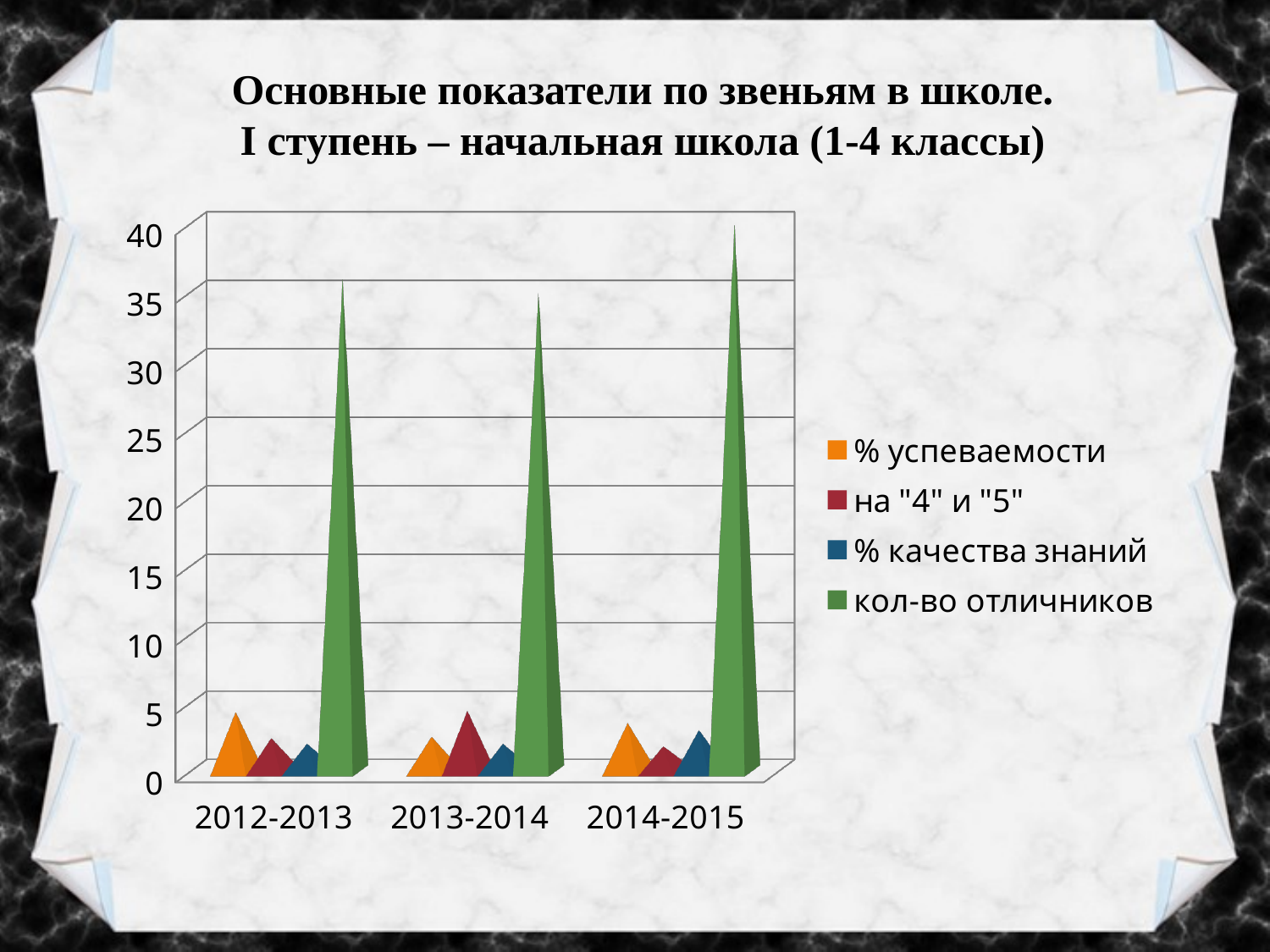
Is the value for "% успеваемости" in 2012-2013 greater or less than 10? less Which is larger: "кол-во отличников" in 2014-2015 or in 2013-2014? 2014-2015 Is the value for "кол-во отличников" in 2014-2015 greater or less than 35? greater How many school years are shown on the x axis? 3 Is the value for "кол-во отличников" in 2013-2014 greater or less than 30? greater Which series has the highest value in every school year shown? кол-во отличников In 2013-2014, which is larger: "на "4" и "5"" or "% успеваемости"? на "4" и "5" In which school year is the value for "кол-во отличников" the highest? 2014-2015 How many series does the legend list? 4 Which series is shown in green in the legend? кол-во отличников What kind of chart is shown on the slide? bar chart In 2012-2013, which is larger: "% успеваемости" or "на "4" и "5""? % успеваемости